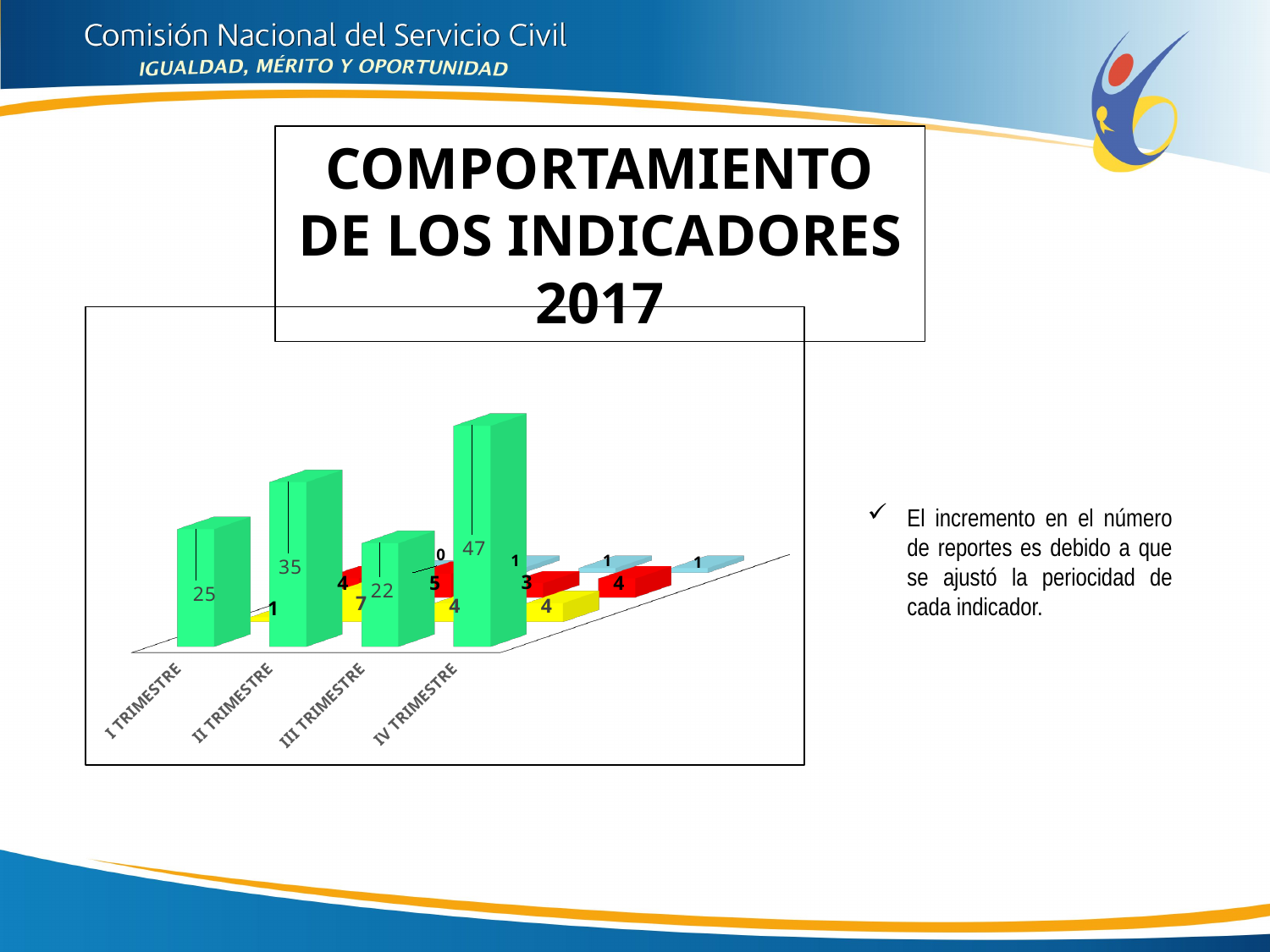
Which has a larger green bar, II TRIMESTRE or III TRIMESTRE? II TRIMESTRE Which trimester has the highest green bar? IV TRIMESTRE What is the value of the green bar for II TRIMESTRE? 35 Which trimester has the lowest green bar? III TRIMESTRE What is the title shown above the chart? COMPORTAMIENTO DE LOS INDICADORES 2017 What is the value of the green bar for I TRIMESTRE? 25 What is the value of the green bar for III TRIMESTRE? 22 What is the difference between the green bar values for II TRIMESTRE and III TRIMESTRE? 13 What is the difference between the green bar values for IV TRIMESTRE and I TRIMESTRE? 22 How many trimester categories are shown on the x axis? 4 What is the value of the green bar for IV TRIMESTRE? 47 What kind of chart is shown on the slide? Bar chart